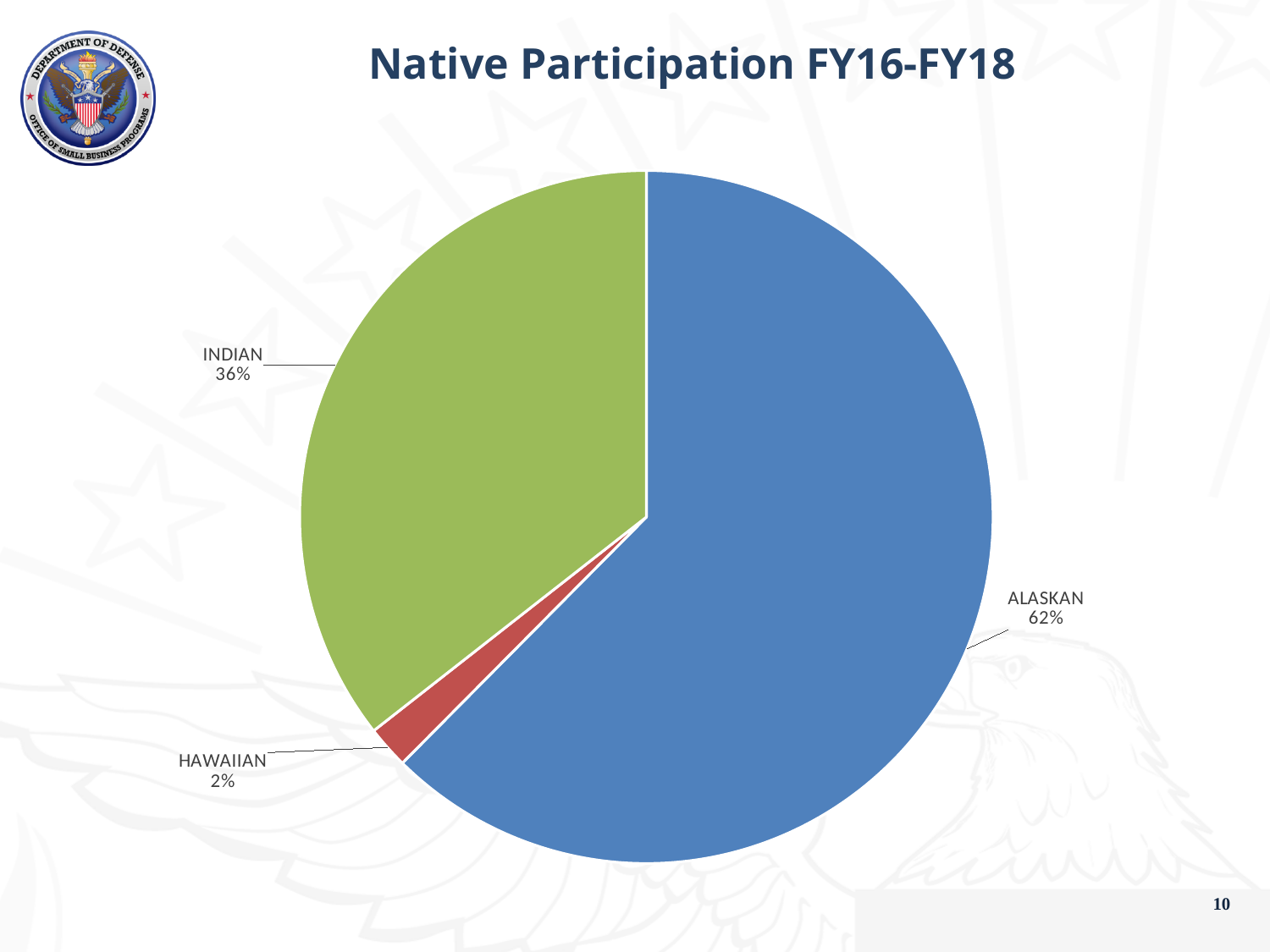
What colour is the ALASKAN slice? Blue What share of the pie does INDIAN represent? 36% Which category has the smallest slice of the pie? HAWAIIAN What type of chart is shown on the slide? Pie chart What is the title of the chart? Native Participation FY16-FY18 Which category has the largest slice of the pie? ALASKAN How many categories are shown in the pie chart? 3 What share of the pie does HAWAIIAN represent? 2% What is the difference in percentage points between the INDIAN and HAWAIIAN slices? 34 What share of the pie does ALASKAN represent? 62% What is the difference in percentage points between the ALASKAN and INDIAN slices? 26 Which is larger, the INDIAN slice or the HAWAIIAN slice? INDIAN